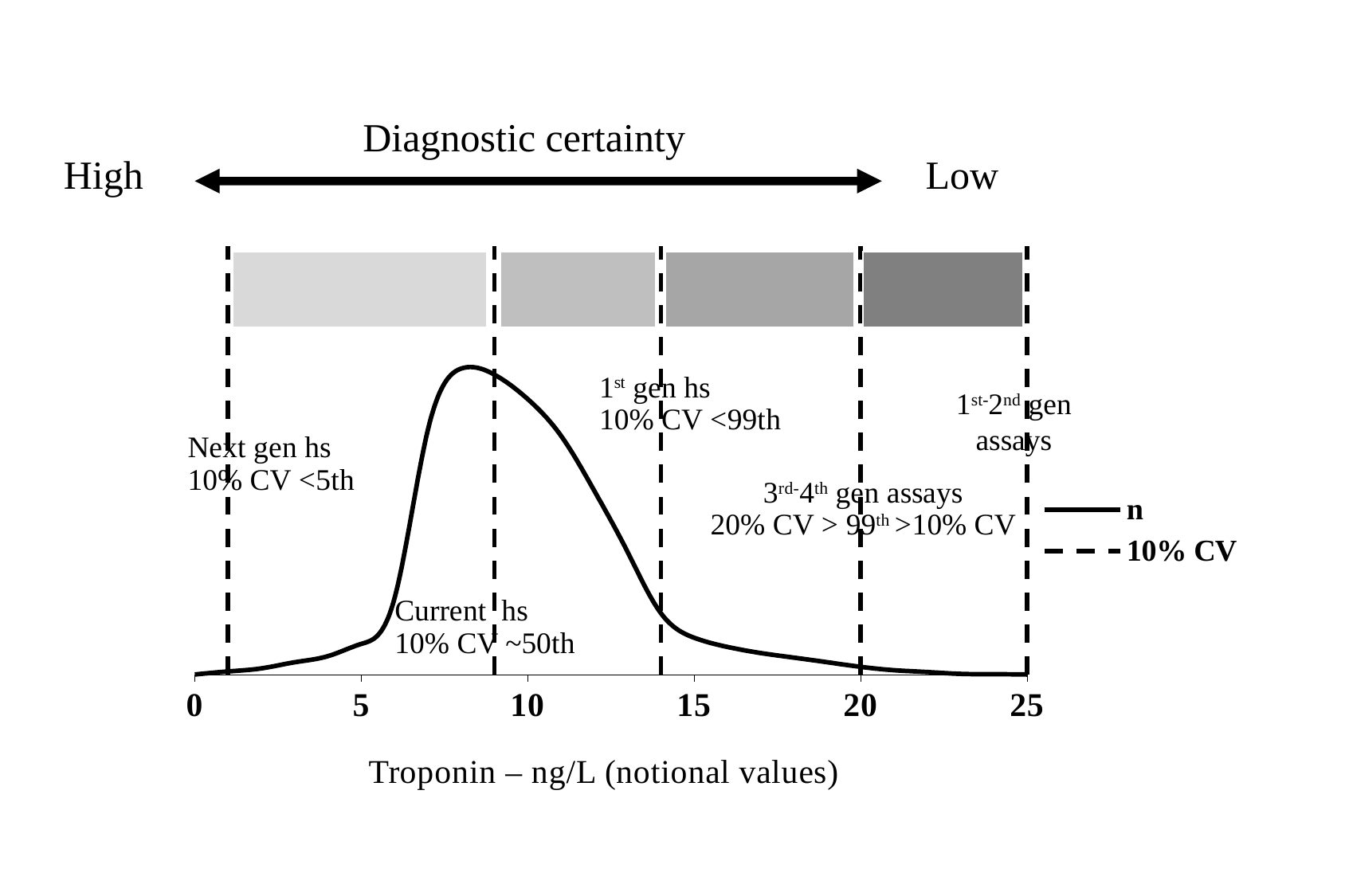
Is the troponin value at the peak of the curve greater or less than 10? less How many dashed vertical 10% CV lines are drawn on the chart? 5 Does the curve rise or fall as troponin increases from 10 to 15 ng/L? fall Which shaded band is the darkest: the leftmost or the rightmost? rightmost What are the two legend entries? n and 10% CV How many entries does the legend list? 2 Does the curve rise or fall as troponin increases from 5 to 8 ng/L? rise Is the troponin value at the peak of the curve greater or less than 5? greater What kind of chart is shown on the slide? line chart How many shaded bands are shown above the curve? 4 What is the highest tick value shown on the x axis? 25 What is the x-axis title of the chart? Troponin – ng/L (notional values)